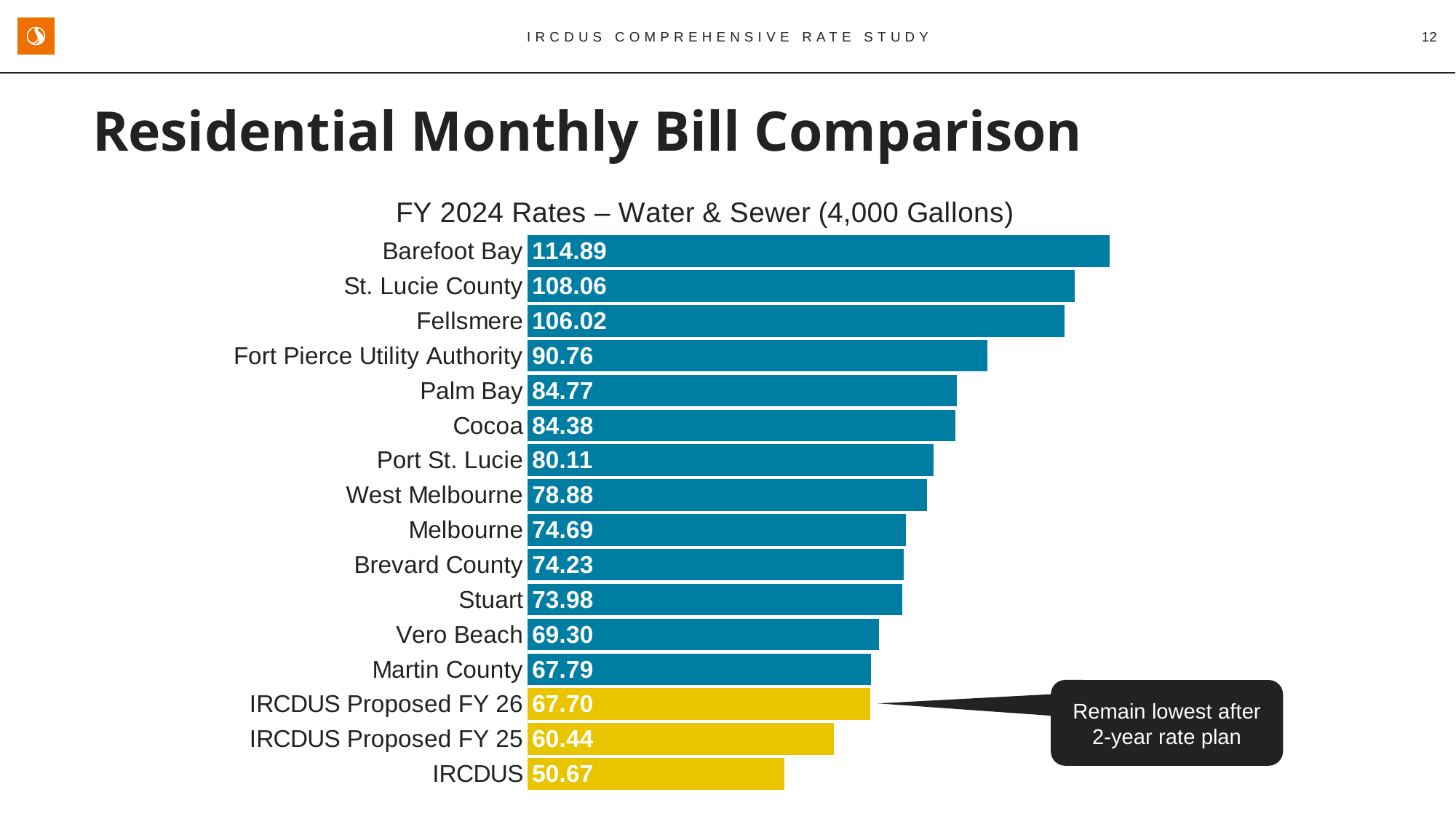
What is the value for Vero Beach? 69.30 What kind of chart is shown on the slide? Bar chart What is the title of the chart? FY 2024 Rates – Water & Sewer (4,000 Gallons) What is the value for Fort Pierce Utility Authority? 90.76 What is the difference between the values for Martin County and IRCDUS Proposed FY 26? 0.09 How many categories are shown in the chart? 16 What is the value for IRCDUS Proposed FY 25? 60.44 Which is larger, the value for Palm Bay or the value for Port St. Lucie? Palm Bay What is the difference between the values for Barefoot Bay and IRCDUS? 64.22 Which category has the highest value? Barefoot Bay What is the value for Barefoot Bay? 114.89 Which category has the lowest value? IRCDUS